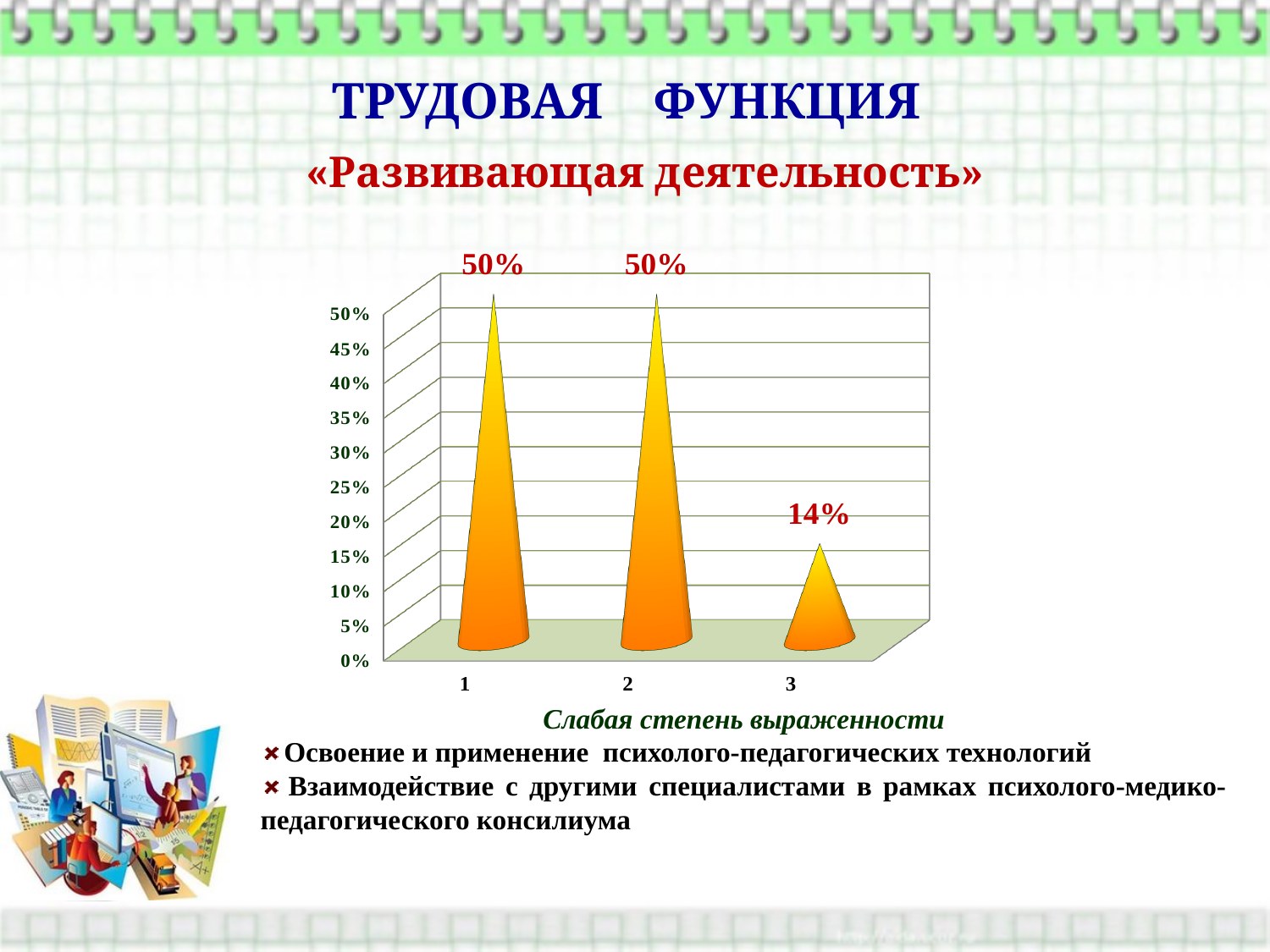
What is the value for category 2? 50% What is the value for category 3? 14% Which is larger, the value for category 1 or the value for category 3? category 1 What is the value for category 1? 50% What is the highest value shown on the vertical axis? 50% Which category has the lowest value? 3 How many categories are shown on the x axis? 3 Is the value for category 3 greater or less than 20%? less What kind of chart is shown on the slide? bar chart Do the values rise or fall from category 1 to category 3? fall Is the value for category 1 greater or less than 40%? greater What is the difference between the value for category 2 and the value for category 3? 36%